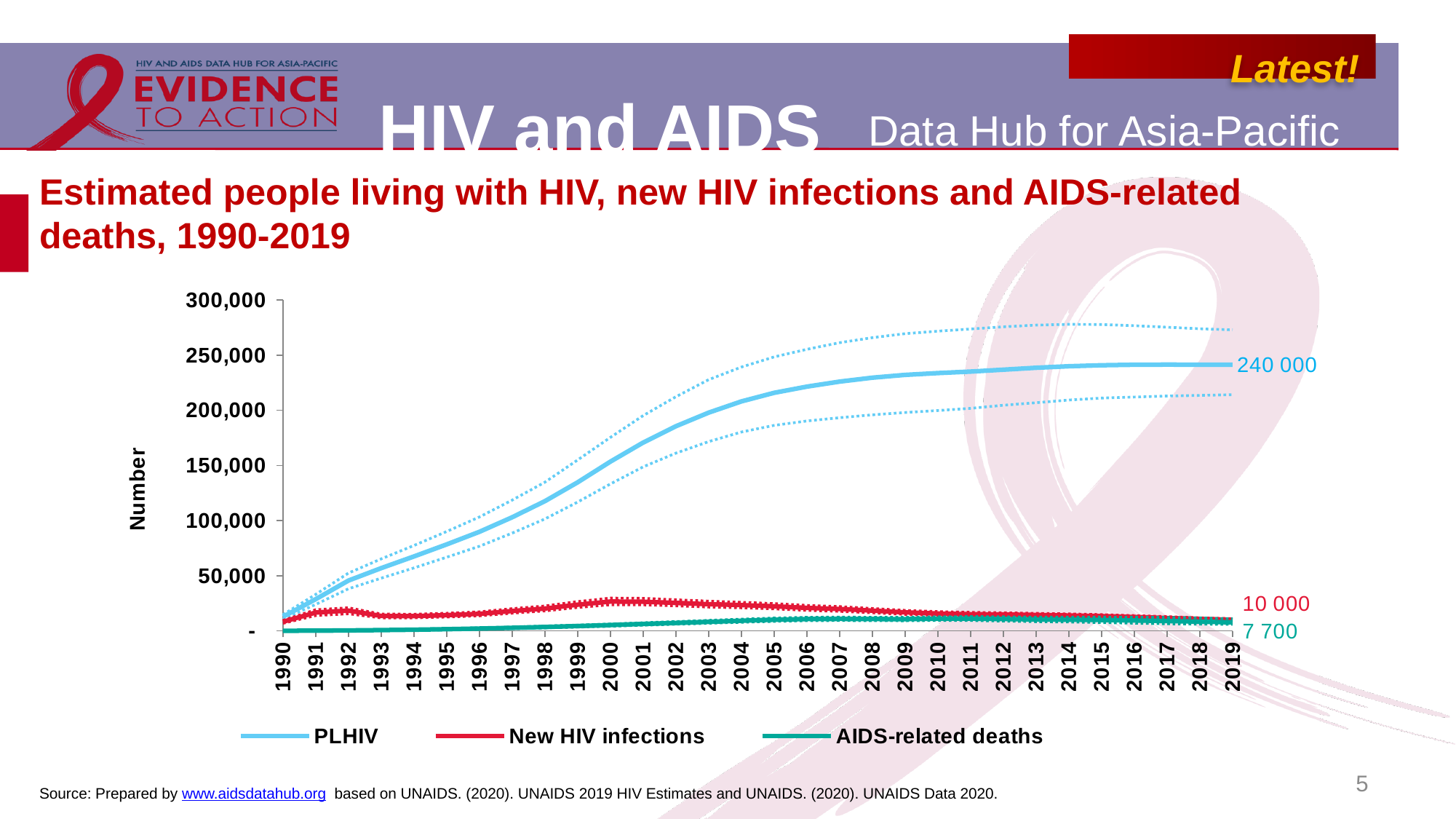
Which series has the highest value in 2019? PLHIV What kind of chart is shown on the slide? Line chart What is the value for New HIV infections in 2019? 10 000 Does the PLHIV series rise or fall from 1990 to 2019? Rise Is the value for PLHIV in 1996 greater or less than 100,000? less Which series has the lowest value in 2019? AIDS-related deaths Which is larger in 2019, PLHIV or New HIV infections? PLHIV What is the value for PLHIV in 2019? 240 000 How many series does the legend list? 3 Is the value for PLHIV in 2005 greater or less than 200,000? greater What is the value for AIDS-related deaths in 2019? 7 700 What is the difference between New HIV infections and AIDS-related deaths in 2019? 2 300